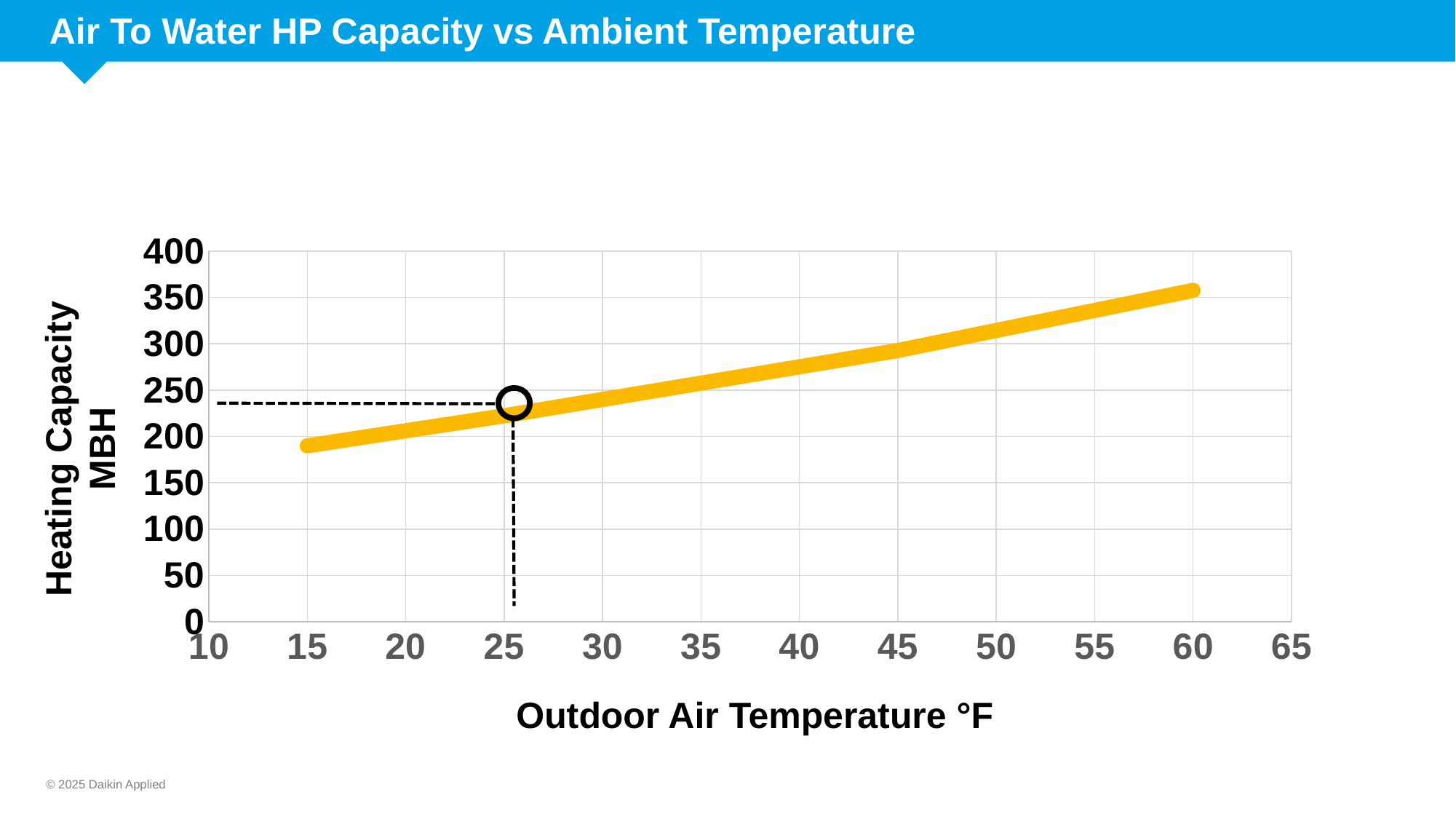
Is the heating capacity at 40°F outdoor air temperature greater or less than 250 MBH? greater Is the heating capacity at 30°F outdoor air temperature greater or less than 300 MBH? less Is the heating capacity at 50°F outdoor air temperature greater or less than 300 MBH? greater At which end of the plotted line is heating capacity lowest? 15°F Which outdoor air temperature shown on the line has the highest heating capacity, 15°F or 60°F? 60°F At which end of the plotted line is heating capacity highest? 60°F What is the label of the y axis? Heating Capacity MBH What is the label of the x axis? Outdoor Air Temperature °F What kind of chart is shown on the slide? line chart Does heating capacity rise or fall as outdoor air temperature increases along the x axis? rise